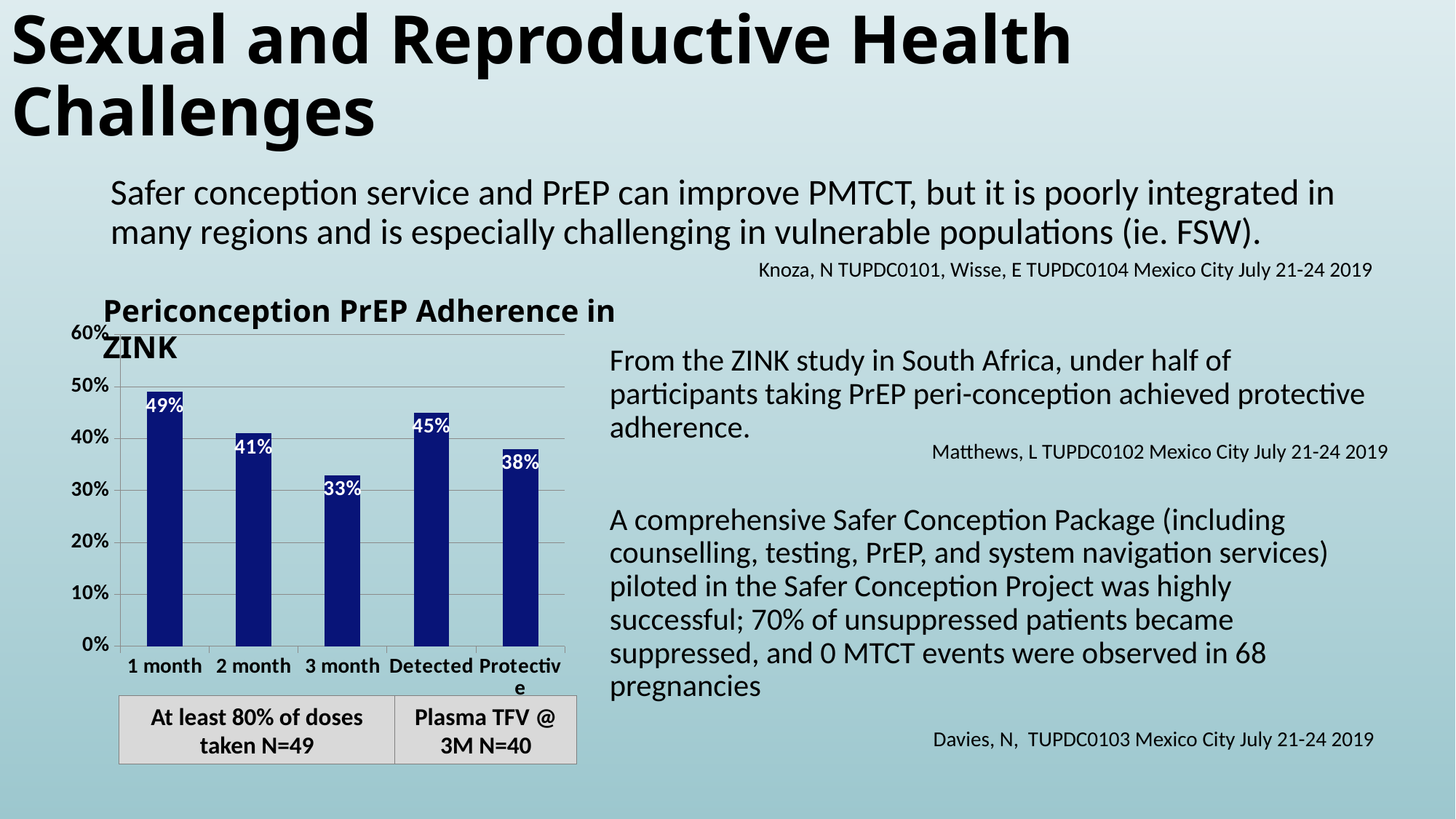
What is the value for 1 month in the Periconception PrEP Adherence in ZINK chart? 49% Is the value for 2 month in the Periconception PrEP Adherence in ZINK chart greater or less than 50%? less How many categories are shown on the x axis of the Periconception PrEP Adherence in ZINK chart? 5 What is the value for 3 month in the Periconception PrEP Adherence in ZINK chart? 33% What kind of chart is the Periconception PrEP Adherence in ZINK chart? bar chart Which is larger in the Periconception PrEP Adherence in ZINK chart, the value for 2 month or the value for Detected? Detected Which category has the lowest value in the Periconception PrEP Adherence in ZINK chart? 3 month What is the value for Detected in the Periconception PrEP Adherence in ZINK chart? 45% What is the value for Protective in the Periconception PrEP Adherence in ZINK chart? 38% What is the difference between the 1 month and 3 month values in the Periconception PrEP Adherence in ZINK chart? 16% Do the values fall or rise from 1 month to 3 month in the Periconception PrEP Adherence in ZINK chart? fall Which category has the highest value in the Periconception PrEP Adherence in ZINK chart? 1 month